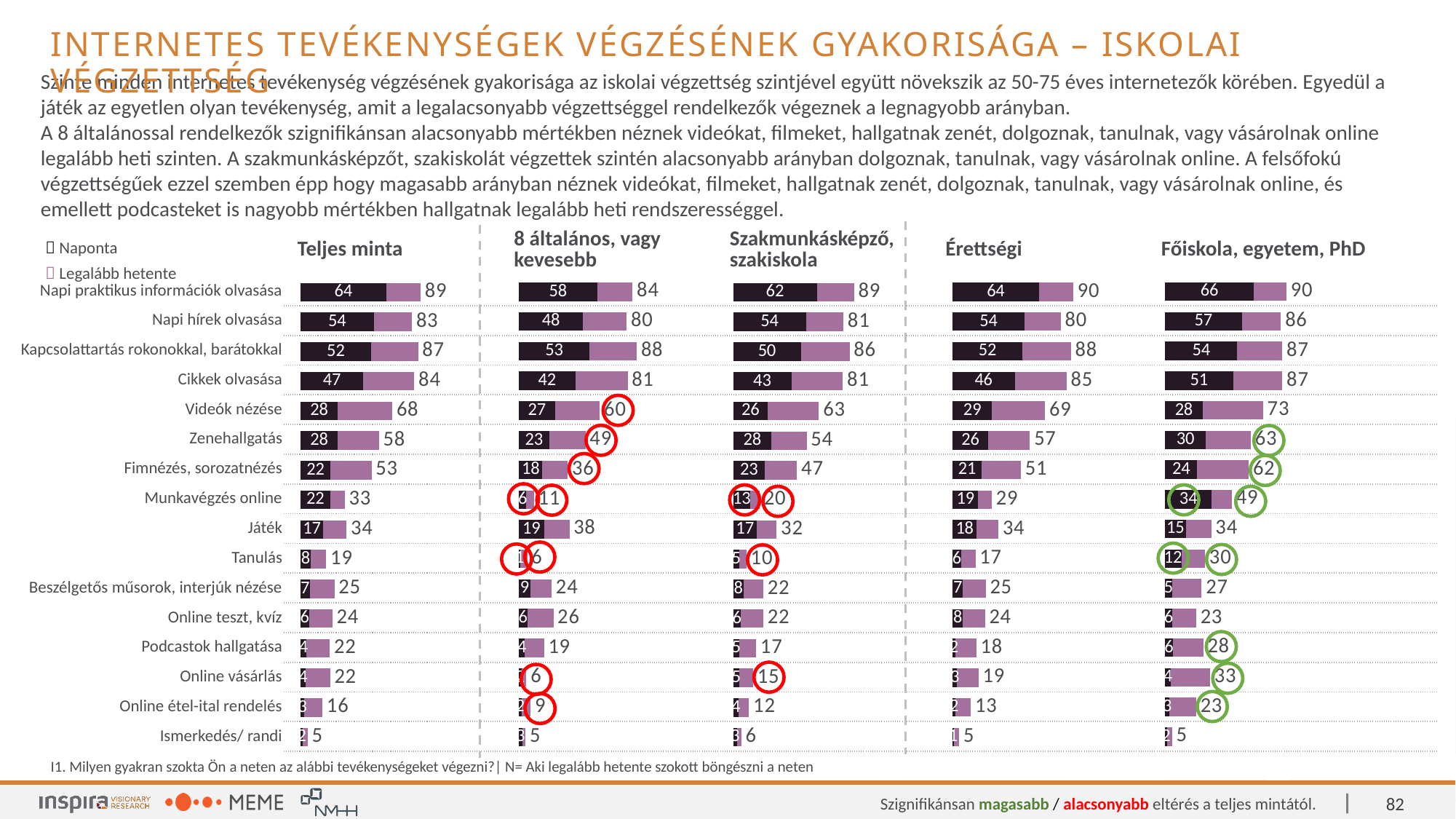
In the 'Szakmunkásképző, szakiskola' chart, what is the 'Legalább hetente' value for 'Tanulás'? 10 How many activities (categories) are listed in each chart? 16 For 'Munkavégzés online', what is the difference between the 'Legalább hetente' value in the 'Főiskola, egyetem, PhD' chart and in the '8 általános, vagy kevesebb' chart? 38 For 'Játék', is the 'Naponta' value larger in the '8 általános, vagy kevesebb' chart or in the 'Főiskola, egyetem, PhD' chart? 8 általános, vagy kevesebb In the 'Főiskola, egyetem, PhD' chart, what is the 'Legalább hetente' value for 'Online vásárlás'? 33 In the 'Teljes minta' chart, which activity has the highest 'Legalább hetente' value? Napi praktikus információk olvasása In the 'Érettségi' chart, which activity has the lowest 'Legalább hetente' value? Ismerkedés/ randi In the 'Teljes minta' chart, what is the 'Naponta' value for 'Napi hírek olvasása'? 54 How many series does the legend list? 2 What are the two legend entries shown on the slide? Naponta; Legalább hetente In the 'Teljes minta' chart, what is the difference between the 'Legalább hetente' and 'Naponta' values for 'Videók nézése'? 40 What kind of chart is used on this slide? Bar chart